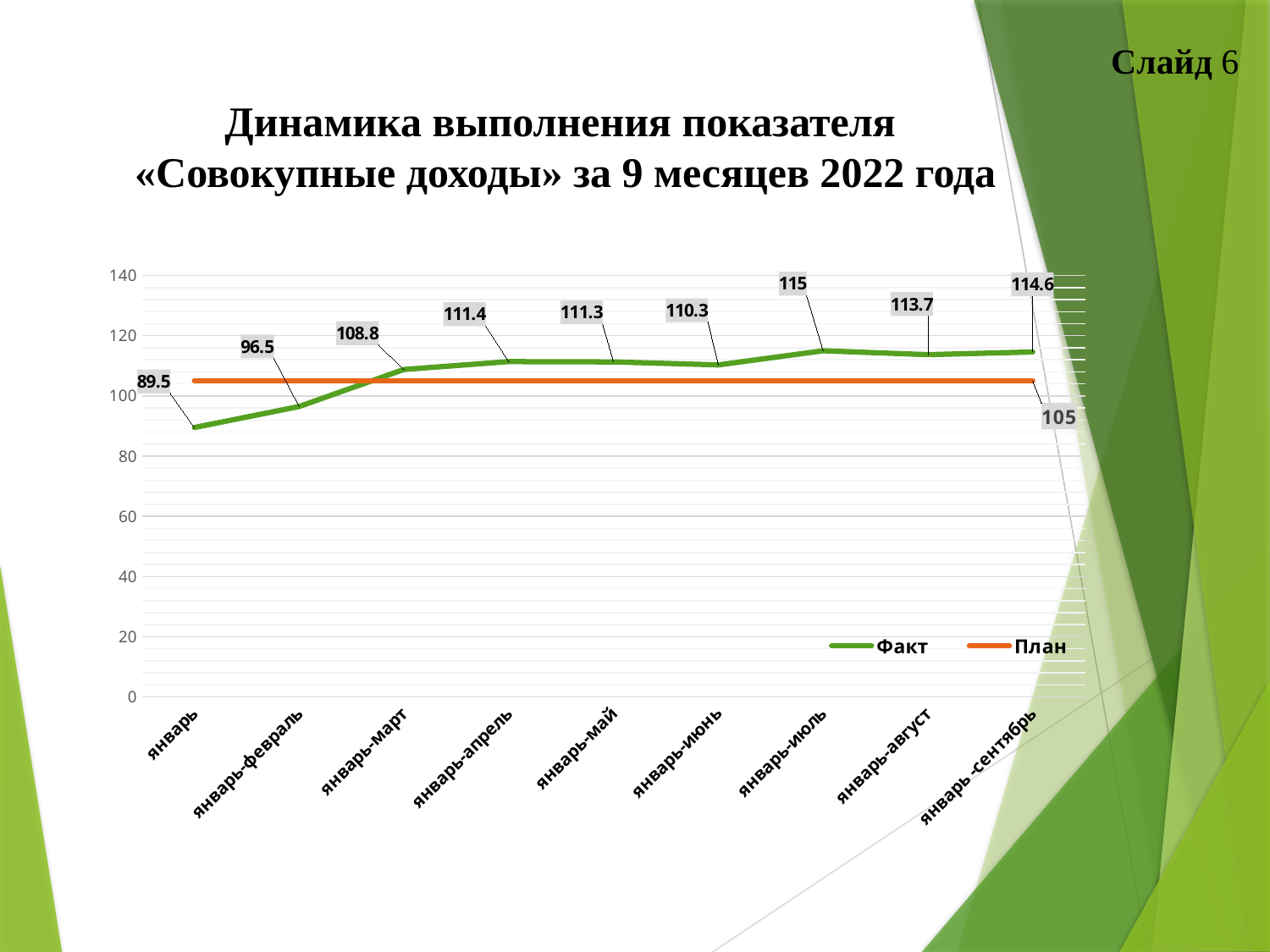
What kind of chart is shown on the slide? line chart How many periods are shown on the x axis? 9 Which period has the highest Факт value? январь-июль What is the Факт value for январь-март? 108.8 Which period has the lowest Факт value? январь Does the Факт line rise or fall from январь to январь-апрель? rise Is the Факт value for январь-февраль greater or less than the План value of 105? less How many series does the legend list? 2 What is the difference between the Факт values for январь-июль and январь? 25.5 What is the value of the План line? 105 What is the Факт value for январь-сентябрь? 114.6 Which is larger, the Факт value for январь-апрель or for январь-май? январь-апрель